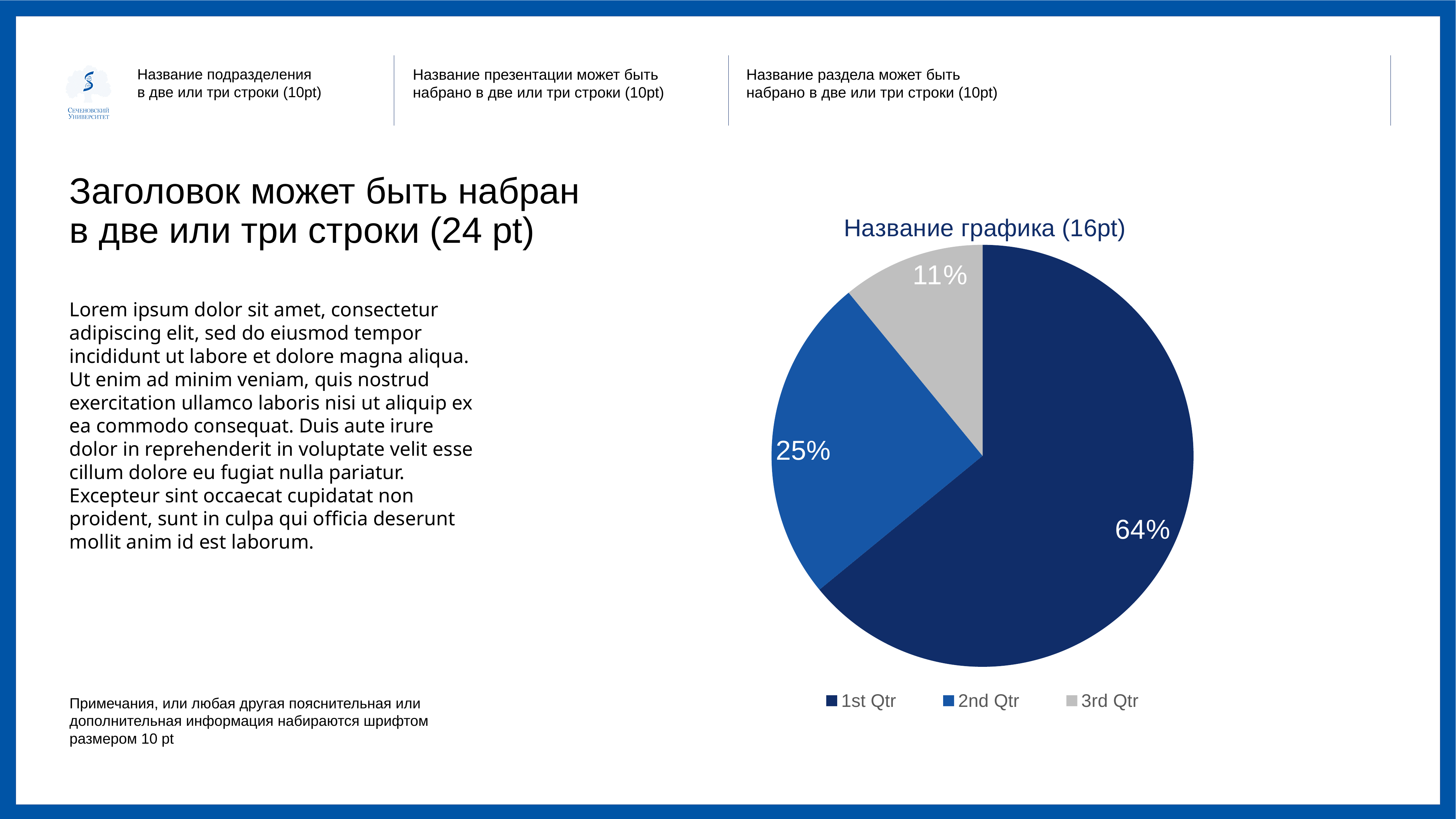
What colour is the 3rd Qtr slice? grey How many entries does the legend list? 3 What share of the pie does 1st Qtr take? 64% What is the title of the chart? Название графика (16pt) What share of the pie does 3rd Qtr take? 11% Which slice of the pie is the smallest? 3rd Qtr How many slices does the pie chart have? 3 What share of the pie does 2nd Qtr take? 25% Which is larger, the share for 2nd Qtr or the share for 3rd Qtr? 2nd Qtr Which slice of the pie is the largest? 1st Qtr What is the difference in percentage points between the 1st Qtr share and the 2nd Qtr share? 39 What kind of chart is shown on the slide? pie chart